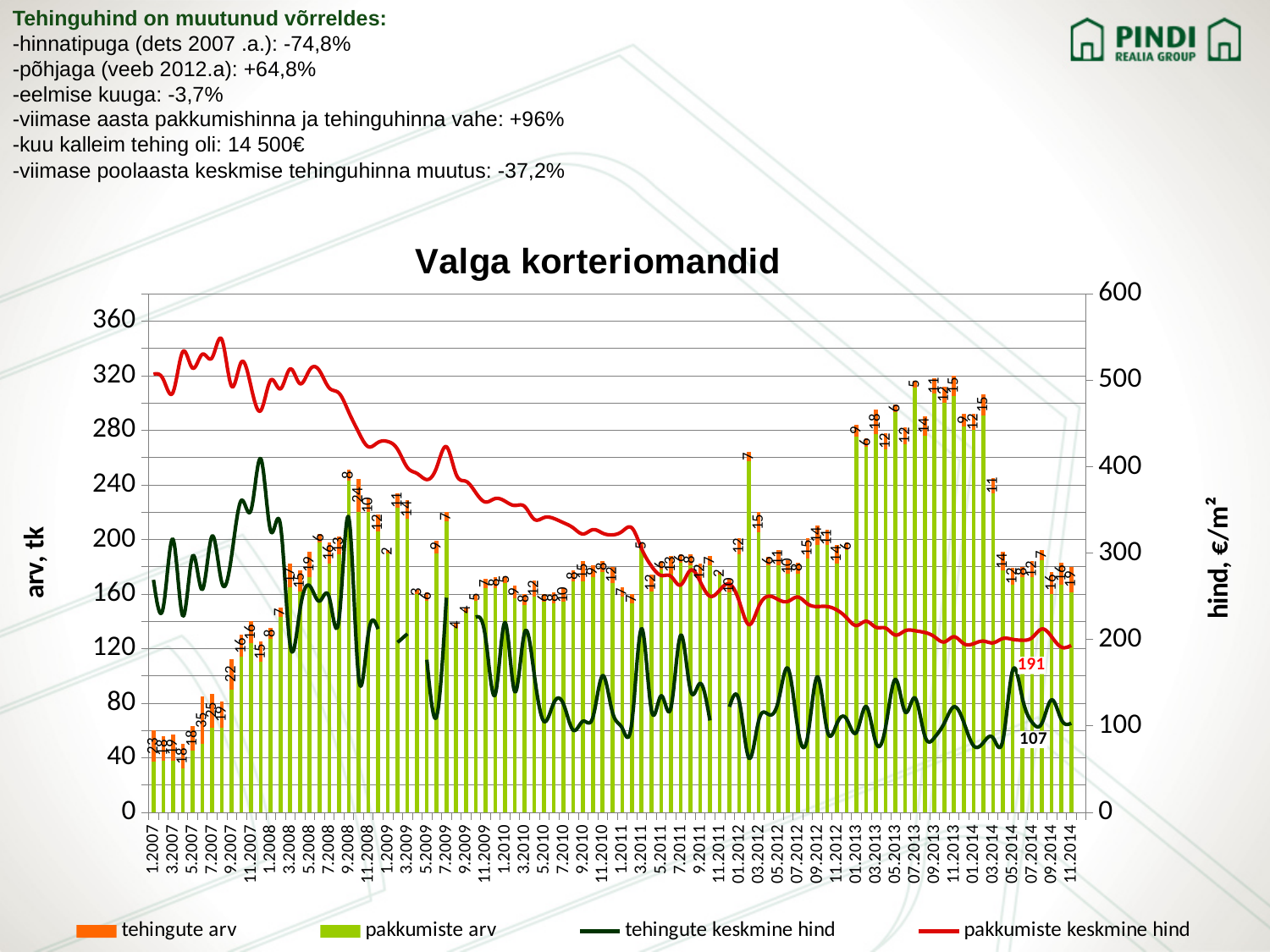
What is the last labelled value of the tehingute keskmine hind line? 107 In which year does the pakkumiste keskmine hind line reach its highest level? 2007 What is the difference between the last labelled values of pakkumiste keskmine hind (191) and tehingute keskmine hind (107)? 84 What is the title of the chart? Valga korteriomandid What kind of chart is this? Combined bar and line chart Is the pakkumiste keskmine hind value at the start of 2007 greater or less than 400 €/m²? greater How many series does the chart legend list? 4 At the end of the period, which is higher: pakkumiste keskmine hind or tehingute keskmine hind? pakkumiste keskmine hind What is the label of the right-hand vertical axis? hind, €/m² Does the pakkumiste keskmine hind line rise or fall overall from 2007 to 2014? fall Is the tehingute keskmine hind value in 2014 greater or less than 200 €/m²? less What is the last labelled value of the pakkumiste keskmine hind line? 191